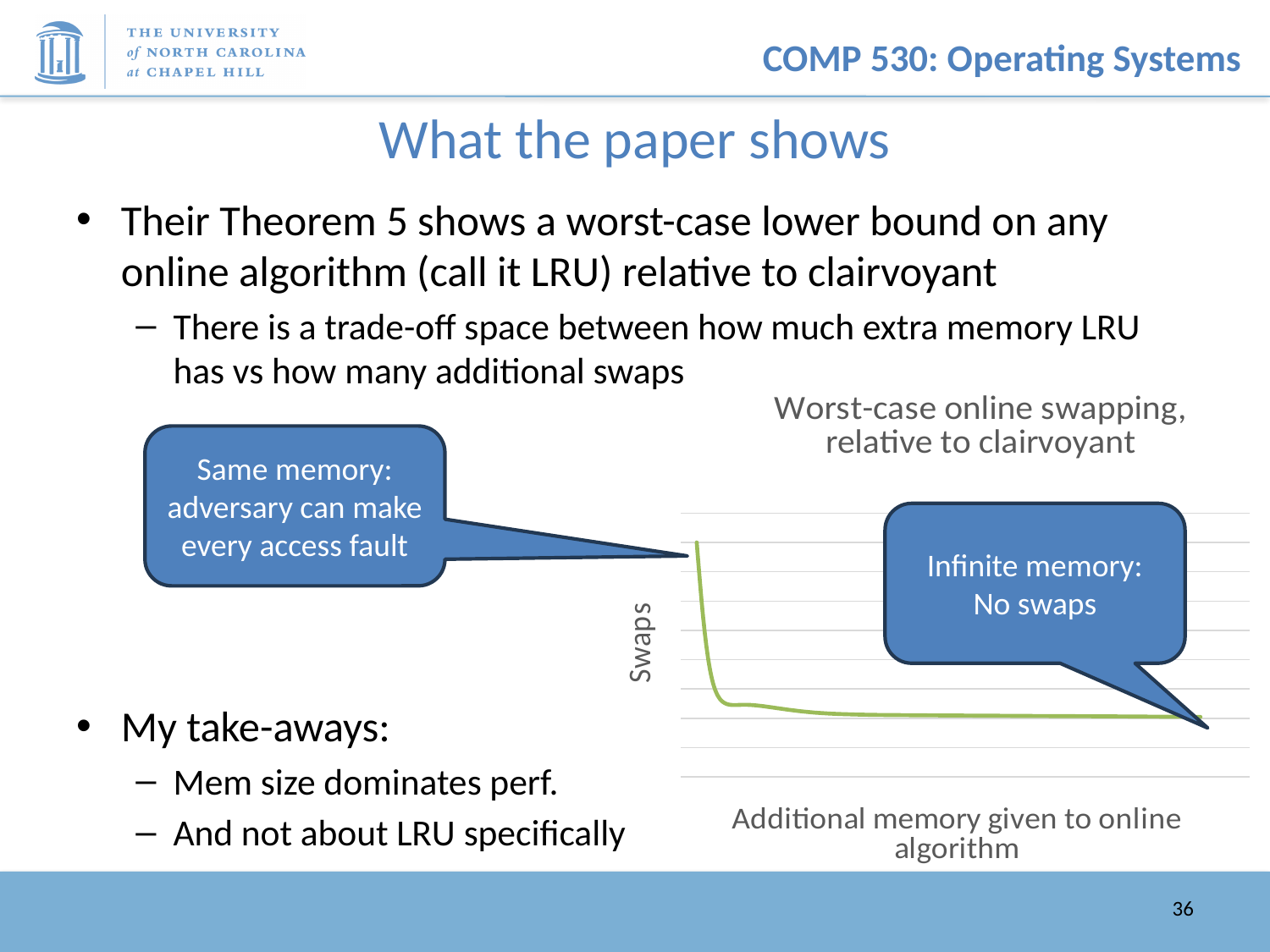
What is the label on the chart's vertical axis? Swaps Do the values in the chart rise or fall as additional memory given to the online algorithm increases along the x axis? Fall What kind of chart is shown on the slide? Line chart What is the title of the chart? Worst-case online swapping, relative to clairvoyant